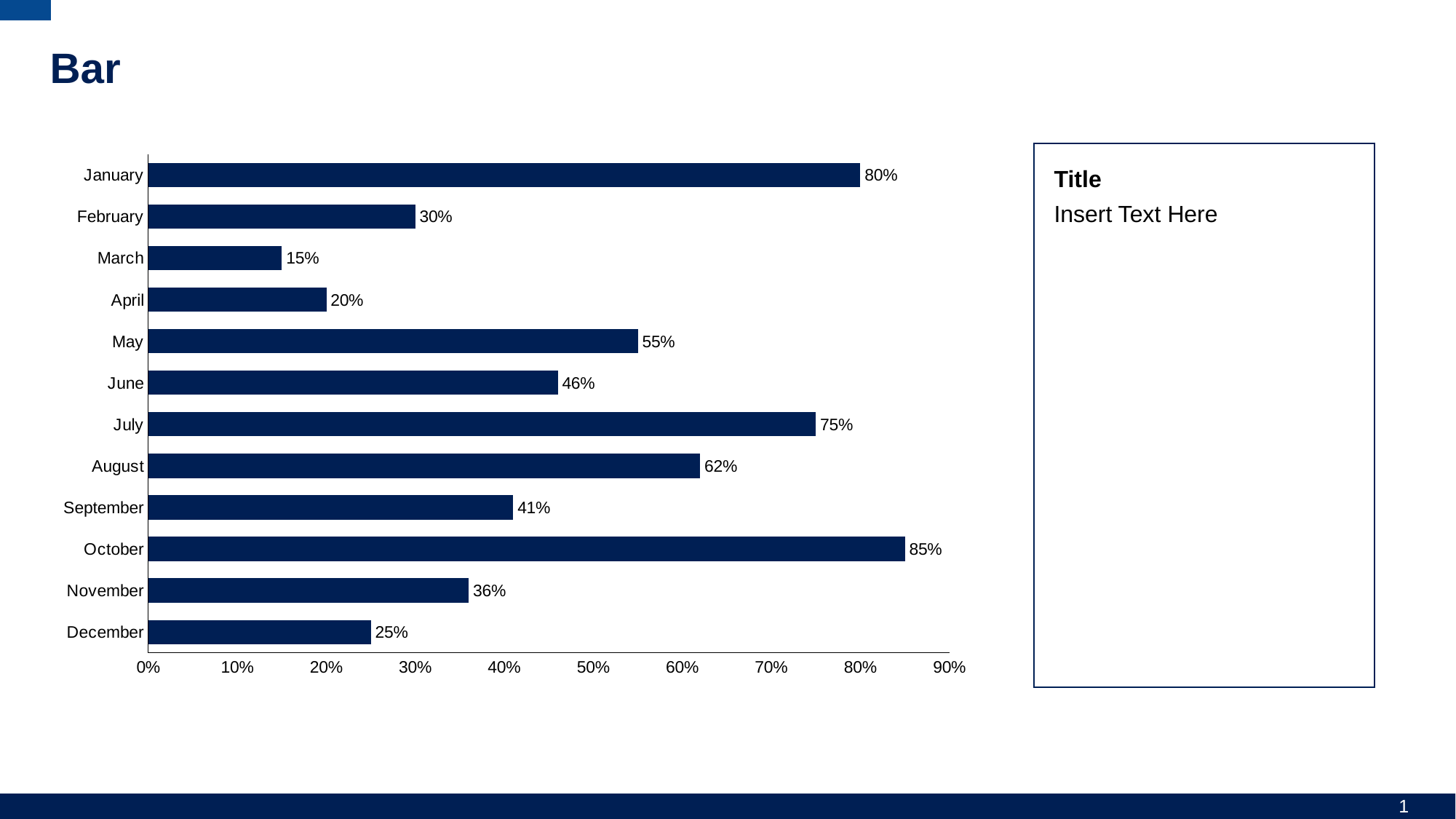
What is the difference between the values for May and April? 35% What is the value for September? 41% Is the value for June greater or less than 50%? less What is the value for January? 80% What is the value for December? 25% Which month has the highest value? October How many months are shown on the chart? 12 What is the maximum value shown on the horizontal axis? 90% Which is larger, the value for July or the value for August? July What kind of chart is shown on the slide? Bar chart What is the difference between the values for October and January? 5% Which month has the lowest value? March